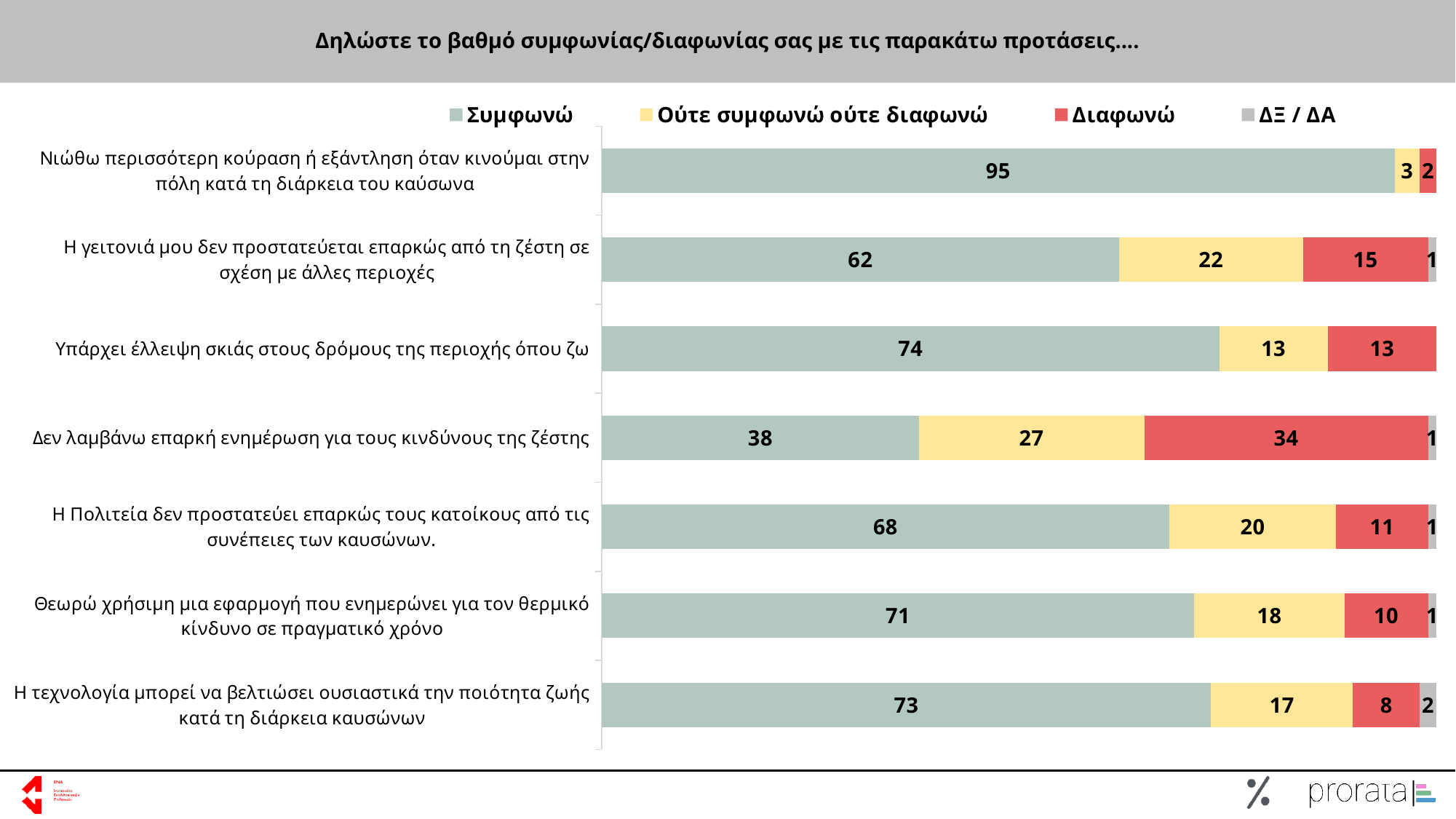
What is the 'Ούτε συμφωνώ ούτε διαφωνώ' value for the statement 'Η γειτονιά μου δεν προστατεύεται επαρκώς από τη ζέστη σε σχέση με άλλες περιοχές'? 22 How many statements (categories) are plotted in the chart? 7 Which statement has the highest Συμφωνώ value? Νιώθω περισσότερη κούραση ή εξάντληση όταν κινούμαι στην πόλη κατά τη διάρκεια του καύσωνα Which legend entry is shown in red? Διαφωνώ What is the Διαφωνώ value for the statement 'Δεν λαμβάνω επαρκή ενημέρωση για τους κινδύνους της ζέστης'? 34 How many series does the legend list? 4 Which statement has the lowest Συμφωνώ value? Δεν λαμβάνω επαρκή ενημέρωση για τους κινδύνους της ζέστης What is the total of the labelled segments for the statement 'Η Πολιτεία δεν προστατεύει επαρκώς τους κατοίκους από τις συνέπειες των καυσώνων.'? 100 What kind of chart is shown on the slide? Stacked bar chart Which is larger: the Διαφωνώ value for 'Η γειτονιά μου δεν προστατεύεται επαρκώς από τη ζέστη σε σχέση με άλλες περιοχές' or for 'Θεωρώ χρήσιμη μια εφαρμογή που ενημερώνει για τον θερμικό κίνδυνο σε πραγματικό χρόνο'? Η γειτονιά μου δεν προστατεύεται επαρκώς από τη ζέστη σε σχέση με άλλες περιοχές What is the difference between the Συμφωνώ values for 'Η τεχνολογία μπορεί να βελτιώσει ουσιαστικά την ποιότητα ζωής κατά τη διάρκεια καυσώνων' and 'Η Πολιτεία δεν προστατεύει επαρκώς τους κατοίκους από τις συνέπειες των καυσώνων.'? 5 What is the Συμφωνώ value for the statement 'Υπάρχει έλλειψη σκιάς στους δρόμους της περιοχής όπου ζω'? 74